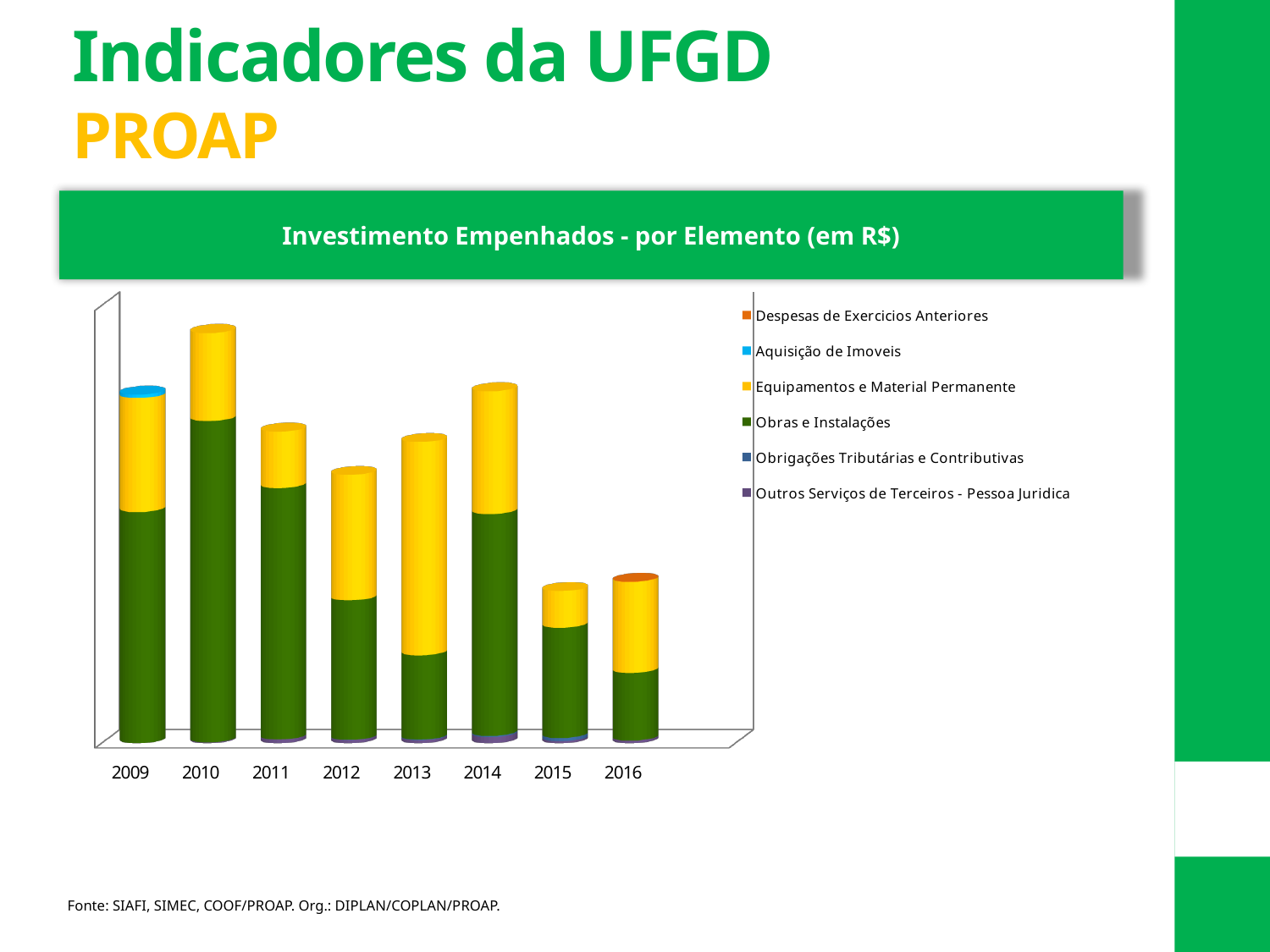
How many years are shown on the x axis of the chart? 8 Which year has the largest Obras e Instalações segment? 2010 Which series is shown in green in the chart? Obras e Instalações Does the total stacked bar height rise or fall from 2014 to 2015? Fall What kind of chart is shown on the slide? Stacked bar chart Which year has the larger Obras e Instalações segment, 2010 or 2016? 2010 Does the total stacked bar height rise or fall from 2009 to 2010? Rise Which year has the largest Equipamentos e Material Permanente segment? 2013 How many series does the chart's legend list? 6 Which stacked bar is taller, 2010 or 2013? 2010 What is the title of the chart? Investimento Empenhados - por Elemento (em R$) Which year has the tallest stacked bar in the chart? 2010